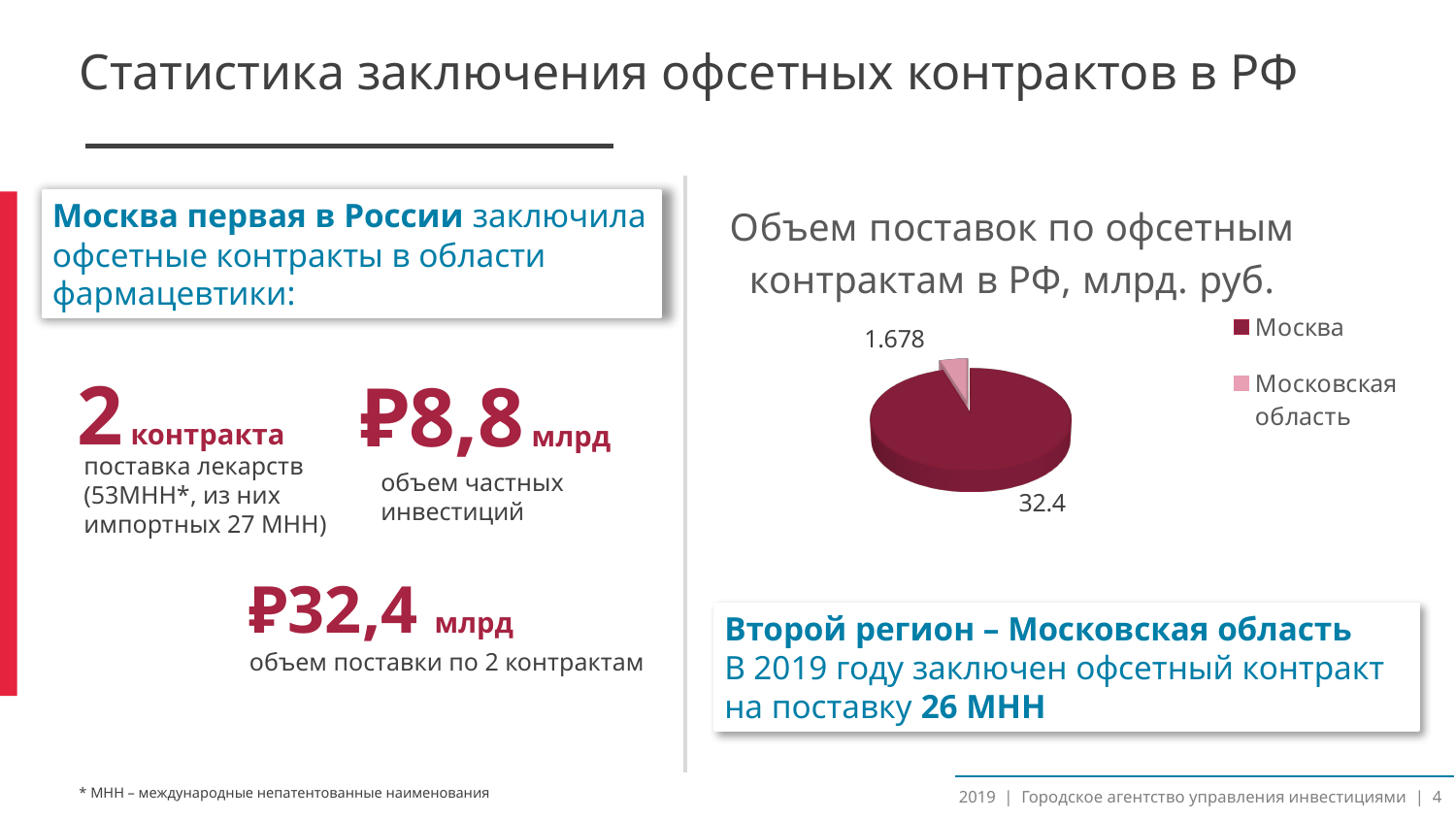
How many entries does the legend of the pie chart list? 2 Which legend entry is shown in the lighter pink colour in the pie chart? Московская область What is the difference between the values for Москва and Московская область in the pie chart? 30.722 What kind of chart is shown on the slide? pie chart Which category has the largest slice in the pie chart? Москва What is the title of the pie chart? Объем поставок по офсетным контрактам в РФ, млрд. руб. How many slices does the pie chart have? 2 What is the value for Московская область in the pie chart? 1.678 Which is larger in the pie chart, Москва or Московская область? Москва What is the value for Москва in the pie chart? 32.4 Which category has the smallest slice in the pie chart? Московская область What is the total of the two values shown in the pie chart? 34.078